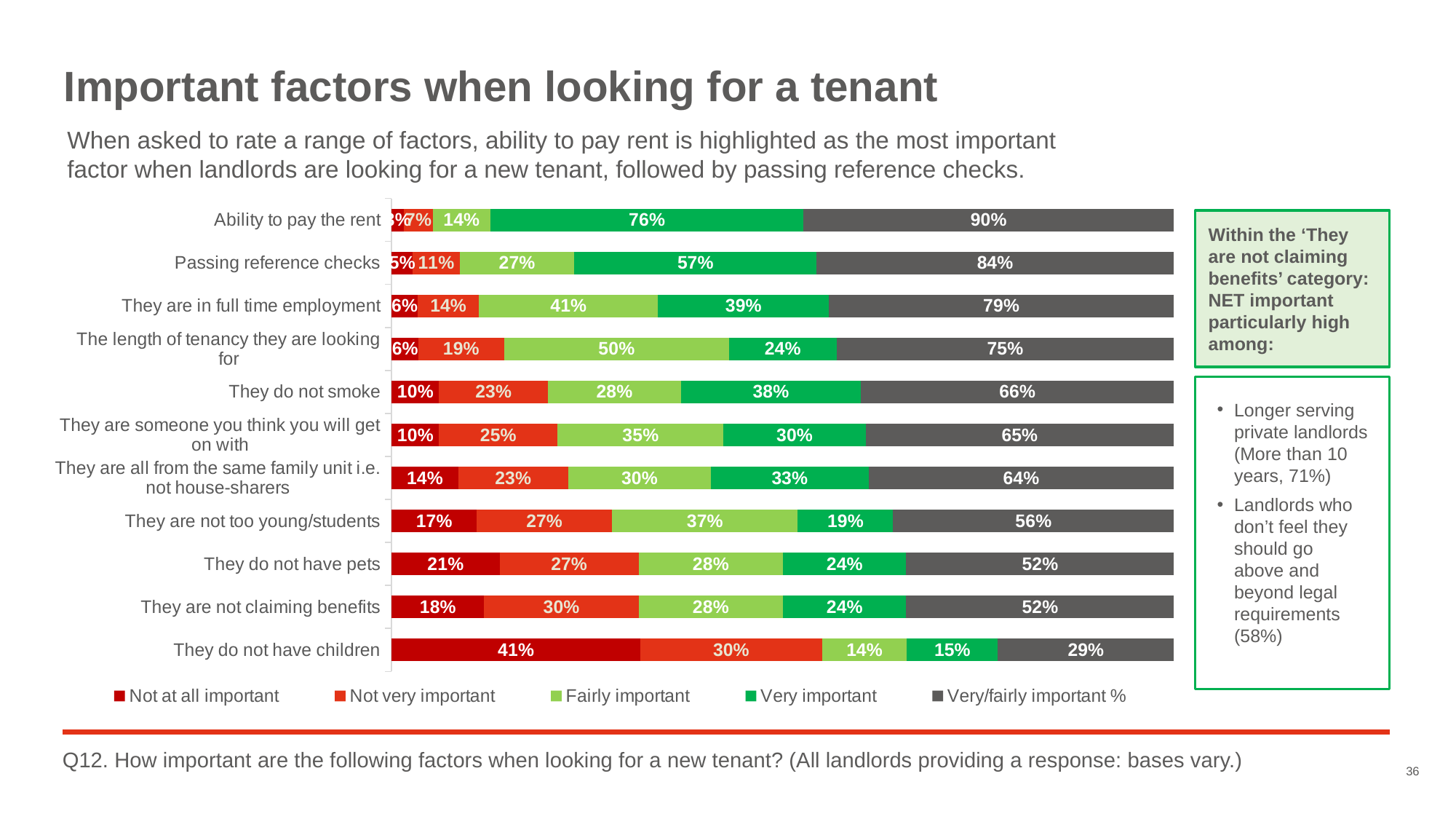
Which legend entry is shown in dark grey? Very/fairly important % What is the Fairly important value for 'The length of tenancy they are looking for'? 50% Which factor has the lowest Very/fairly important % value? They do not have children Which factor has the highest Very/fairly important % value? Ability to pay the rent What is the Very/fairly important % value for 'Ability to pay the rent'? 90% What is the Very important value for 'Passing reference checks'? 57% How many series does the legend list? 5 Which has a larger Very important value: 'They do not smoke' or 'They are someone you think you will get on with'? They do not smoke What percentage of landlords rated 'They do not have children' as Not at all important? 41% How many factors are listed in the chart? 11 What type of chart is shown on the slide? Stacked bar chart What is the difference between the Very/fairly important % values for 'Passing reference checks' and 'They are in full time employment'? 5%